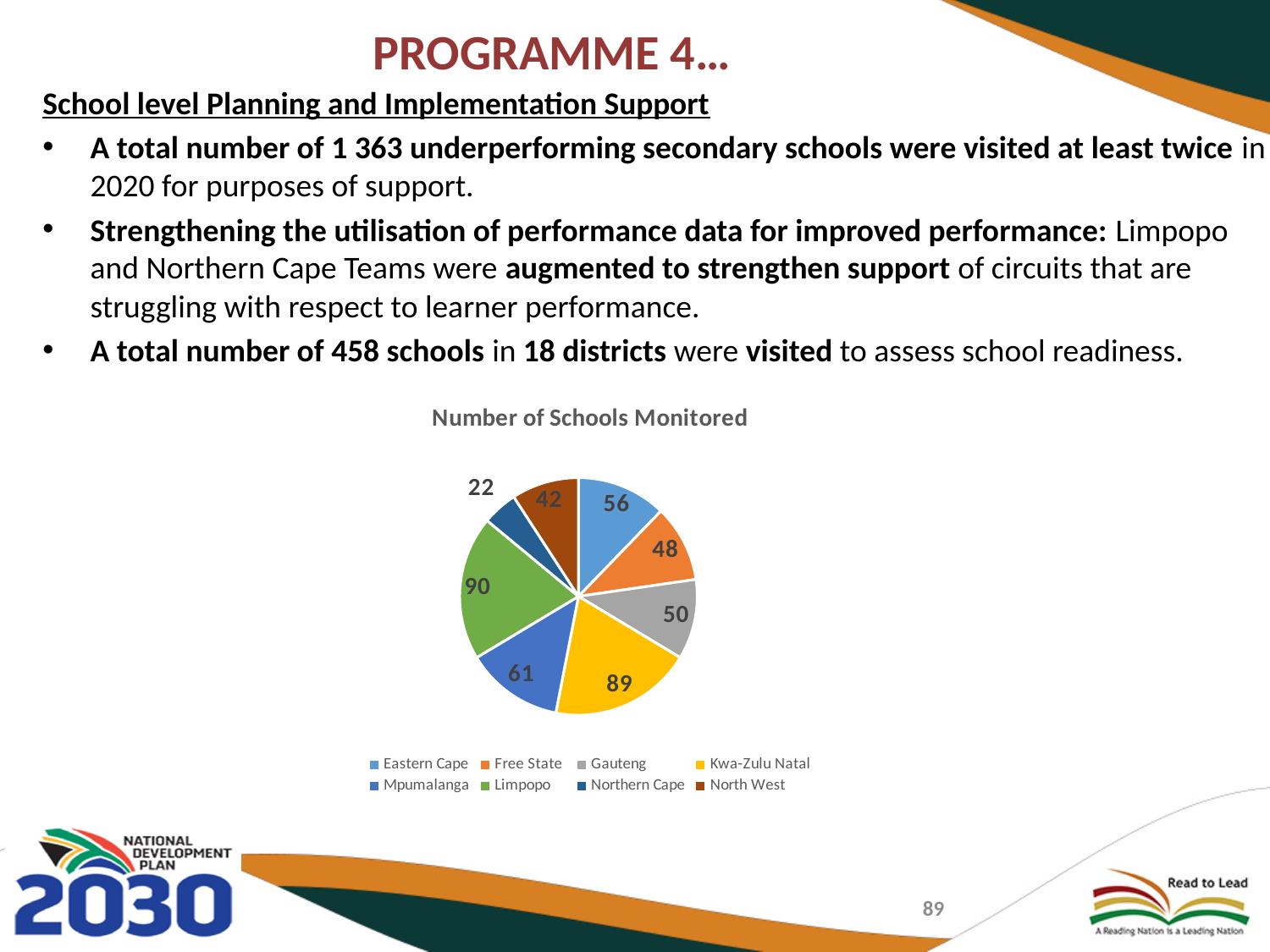
Which has a larger value in the pie chart, Free State or North West? Free State What is the value shown for Northern Cape in the pie chart? 22 What is the total of all the slice values in the pie chart? 458 What is the title of the chart on the slide? Number of Schools Monitored What is the value shown for Kwa-Zulu Natal in the pie chart? 89 Which province has the smallest slice in the pie chart? Northern Cape What is the difference between the values for Limpopo and Mpumalanga in the pie chart? 29 What type of chart is shown under the title "Number of Schools Monitored"? Pie chart How many provinces (slices) are shown in the pie chart? 8 What is the value shown for Gauteng in the pie chart? 50 Which province has the largest slice in the pie chart? Limpopo How many schools were monitored in Eastern Cape according to the pie chart? 56